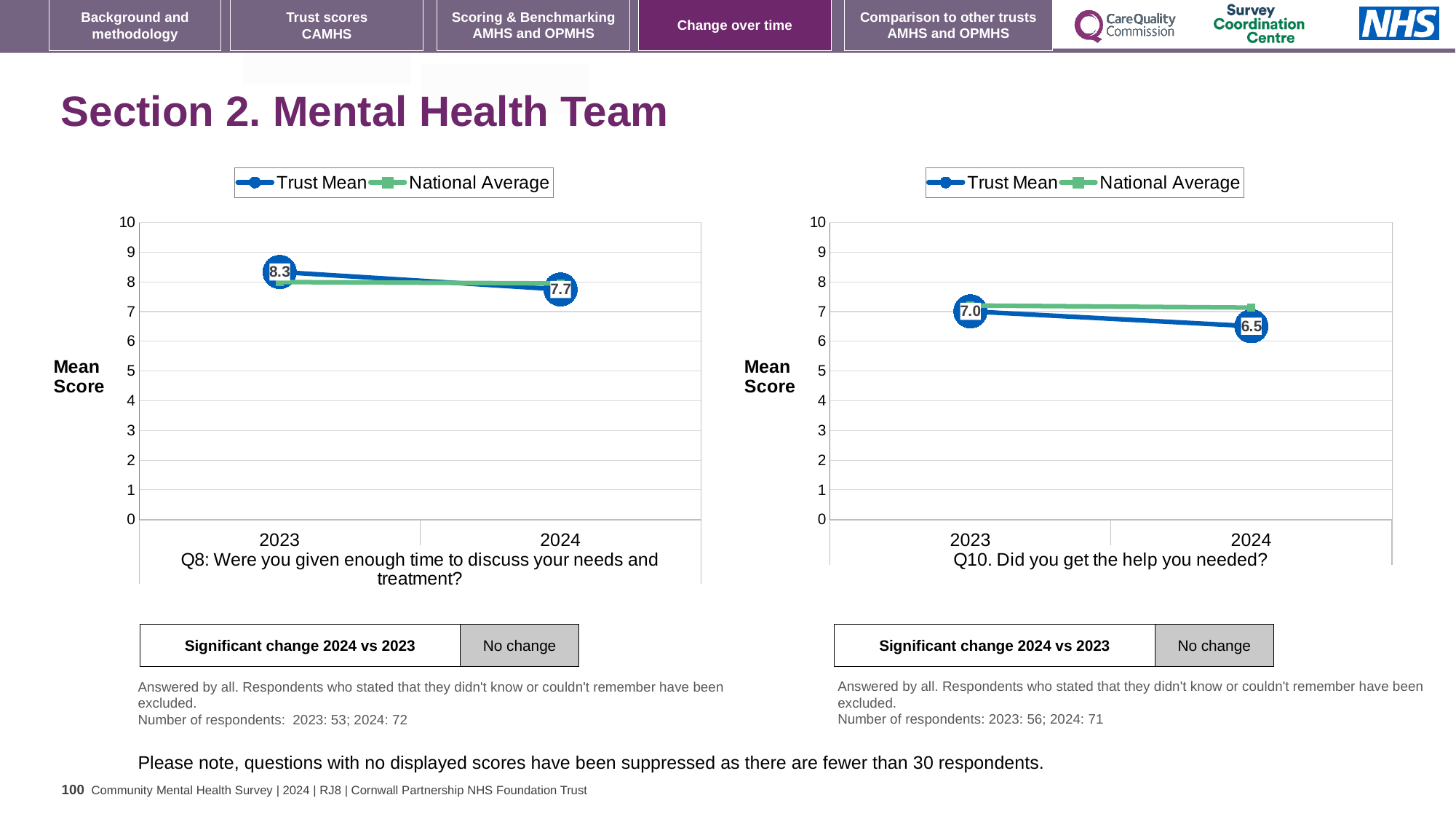
In the Q8 chart (left), what is the Trust Mean for 2023? 8.3 In the Q8 chart (left), what is the Trust Mean for 2024? 7.7 How many series does the legend of the Q8 chart (left) list? 2 In the Q10 chart (right), what is the Trust Mean for 2023? 7.0 In the Q10 chart (right), which is larger in 2024, the Trust Mean or the National Average? National Average What kind of chart is the Q10 chart (right)? line chart In the Q10 chart (right), does the Trust Mean rise or fall from 2023 to 2024? fall In the Q10 chart (right), what is the Trust Mean for 2024? 6.5 In the Q10 chart (right), is the National Average for 2023 greater or less than 6? greater In the Q10 chart (right), what is the difference between the Trust Mean in 2023 and 2024? 0.5 In the Q8 chart (left), does the Trust Mean rise or fall from 2023 to 2024? fall In the Q8 chart (left), by how much did the Trust Mean change from 2023 to 2024? 0.6